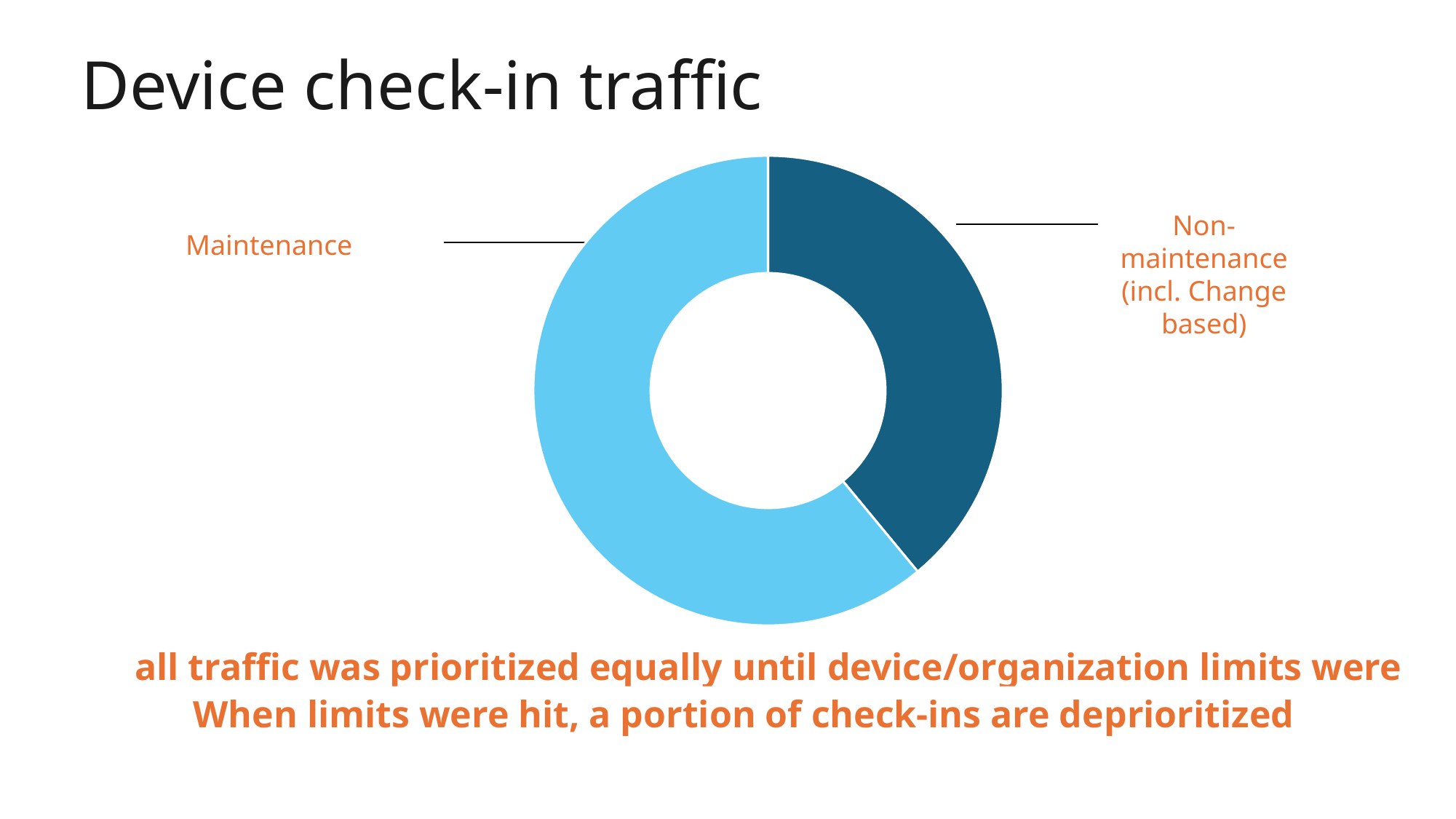
How many slices does the chart have? 2 Which slice is larger, Maintenance or Non-maintenance (incl. Change based)? Maintenance Which category has the smallest share of device check-in traffic? Non-maintenance (incl. Change based) What colour is the Maintenance slice? light blue What kind of chart is shown on the slide? doughnut chart What is the title of the chart? Device check-in traffic Which category has the largest share of device check-in traffic? Maintenance